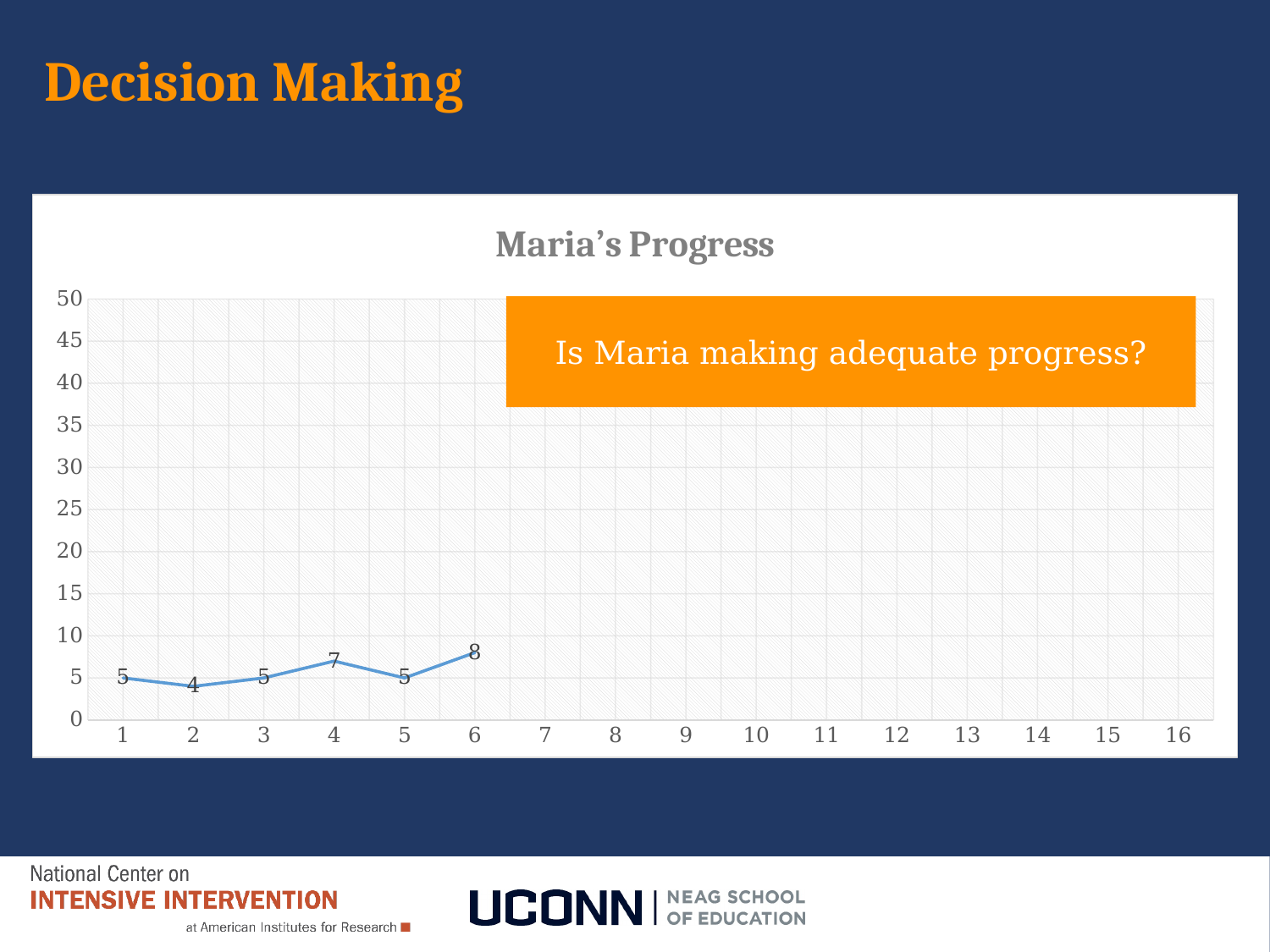
What is the value plotted at point 1? 5 At which x-axis point is the plotted value lowest? 2 What is the value plotted at point 4? 7 How many data points are plotted on the line? 6 What is the title of the chart? Maria's Progress What is the difference between the values at point 6 and point 2? 4 What question is written in the orange box on the chart? Is Maria making adequate progress? What kind of chart is shown on the slide? line chart Which is larger, the value at point 4 or the value at point 5? point 4 At which x-axis point is the plotted value highest? 6 What is the value plotted at point 6? 8 Is the value at point 6 greater or less than 10? less